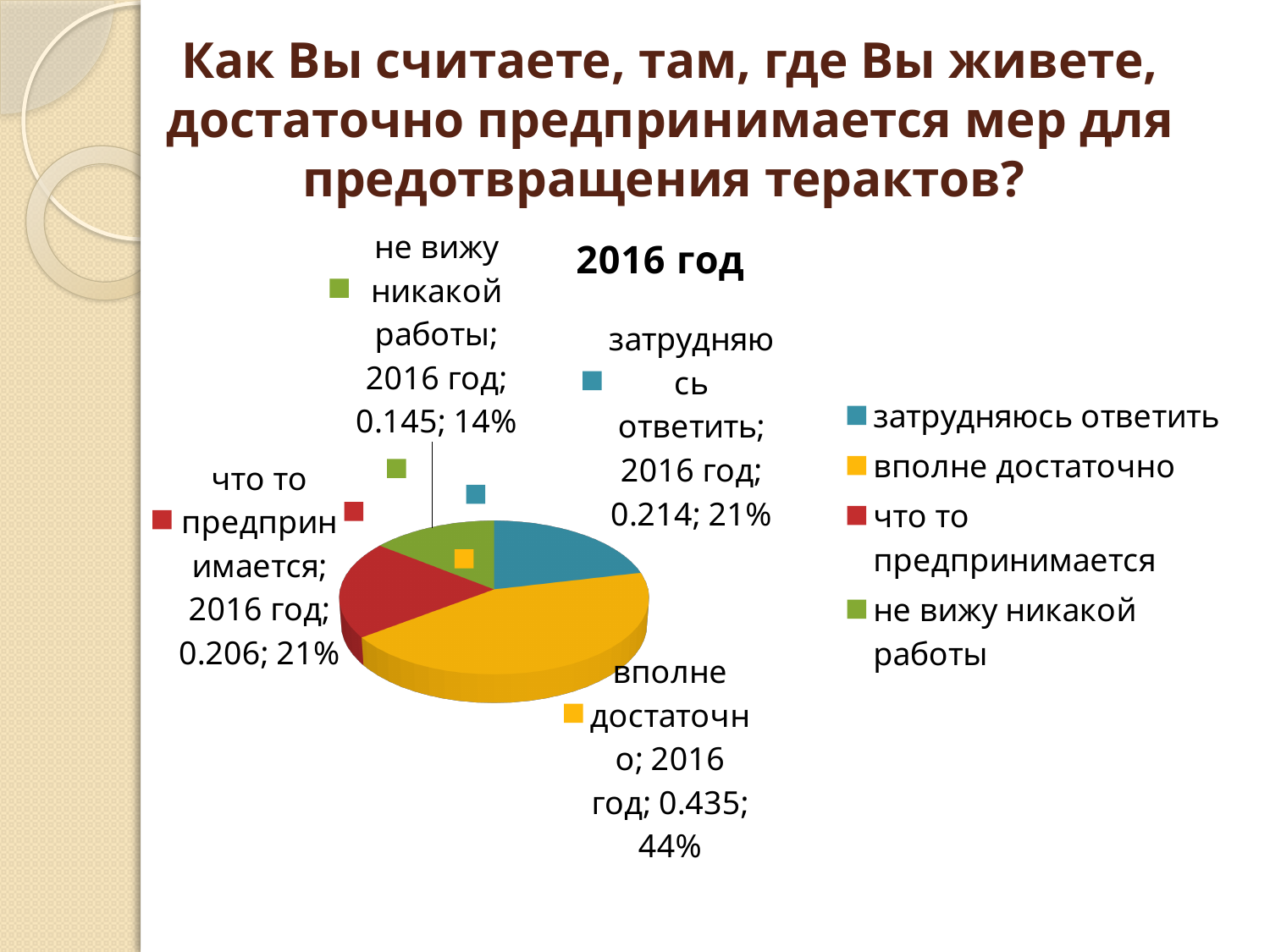
Which category has the smallest slice? не вижу никакой работы What percentage share does the slice 'что то предпринимается' have? 21% What kind of chart is shown on the slide? pie chart Which is larger, the slice for 'вполне достаточно' or the slice for 'не вижу никакой работы'? вполне достаточно What is the difference between the values for 'вполне достаточно' (0.435) and 'не вижу никакой работы' (0.145)? 0.29 What value is shown for 'затрудняюсь ответить'? 0.214 Which category has the largest slice? вполне достаточно What is the title of the chart? 2016 год How many entries does the legend list? 4 What percentage share does the slice 'вполне достаточно' have? 44% What value is shown for 'не вижу никакой работы'? 0.145 How many slices does the pie chart have? 4